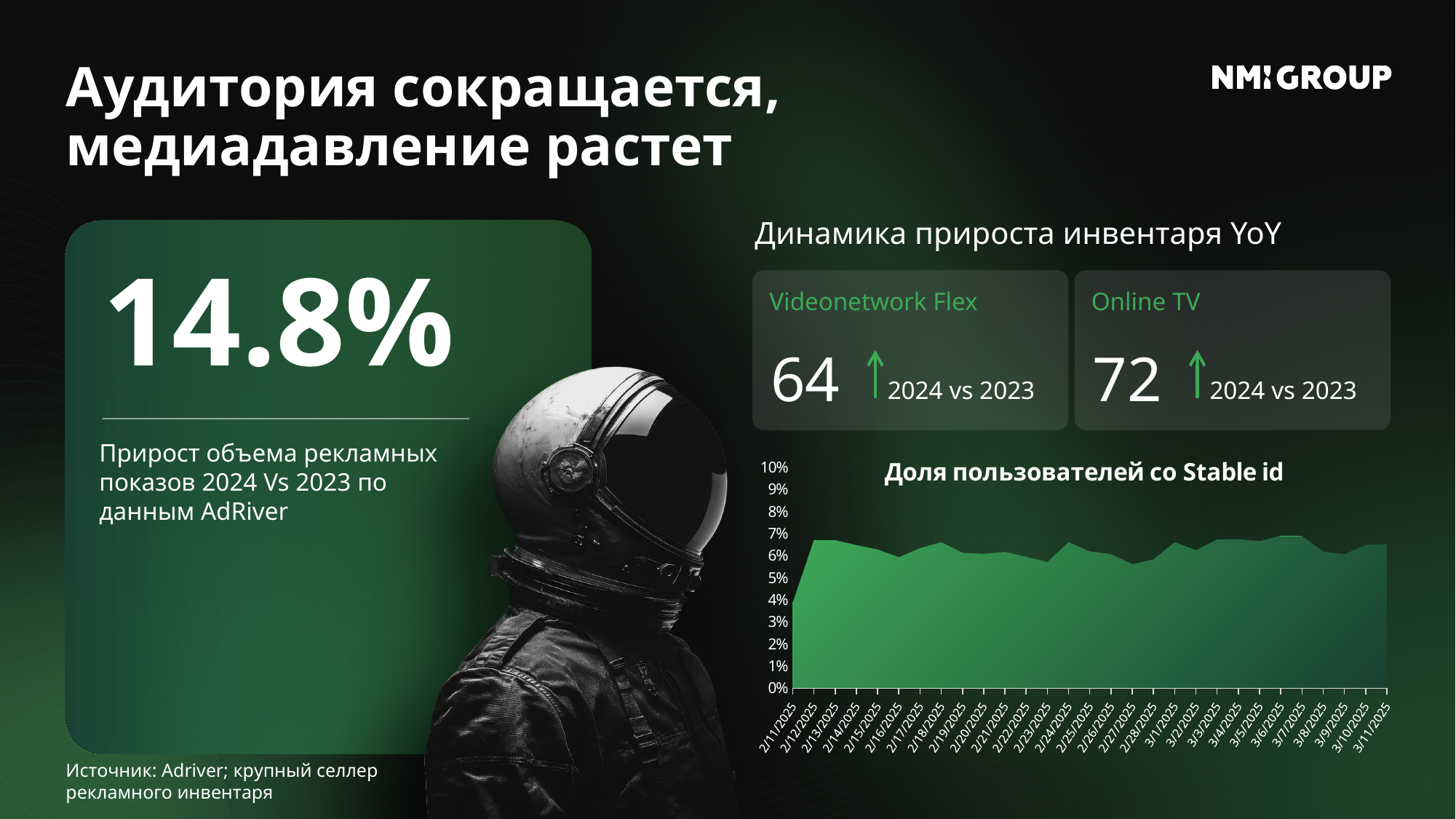
In the "Доля пользователей со Stable id" chart, which date has the lowest value? 2/11/2025 In the "Доля пользователей со Stable id" chart, is the value for 2/12/2025 greater or less than 5%? greater What is the title of the chart on the right side of the slide? Доля пользователей со Stable id What kind of chart is "Доля пользователей со Stable id"? area chart In the "Доля пользователей со Stable id" chart, which is larger: the value for 2/11/2025 or 2/12/2025? 2/12/2025 How many dates are shown on the x axis of the "Доля пользователей со Stable id" chart? 29 In the "Доля пользователей со Stable id" chart, does the value rise or fall from 2/11/2025 to 2/12/2025? rise What is the highest tick shown on the y axis of the "Доля пользователей со Stable id" chart? 10% In the "Доля пользователей со Stable id" chart, is the value for 2/11/2025 greater or less than 5%? less In the "Доля пользователей со Stable id" chart, which is larger: the value for 2/13/2025 or 2/23/2025? 2/13/2025 In the "Доля пользователей со Stable id" chart, is the value for 2/13/2025 greater or less than 8%? less